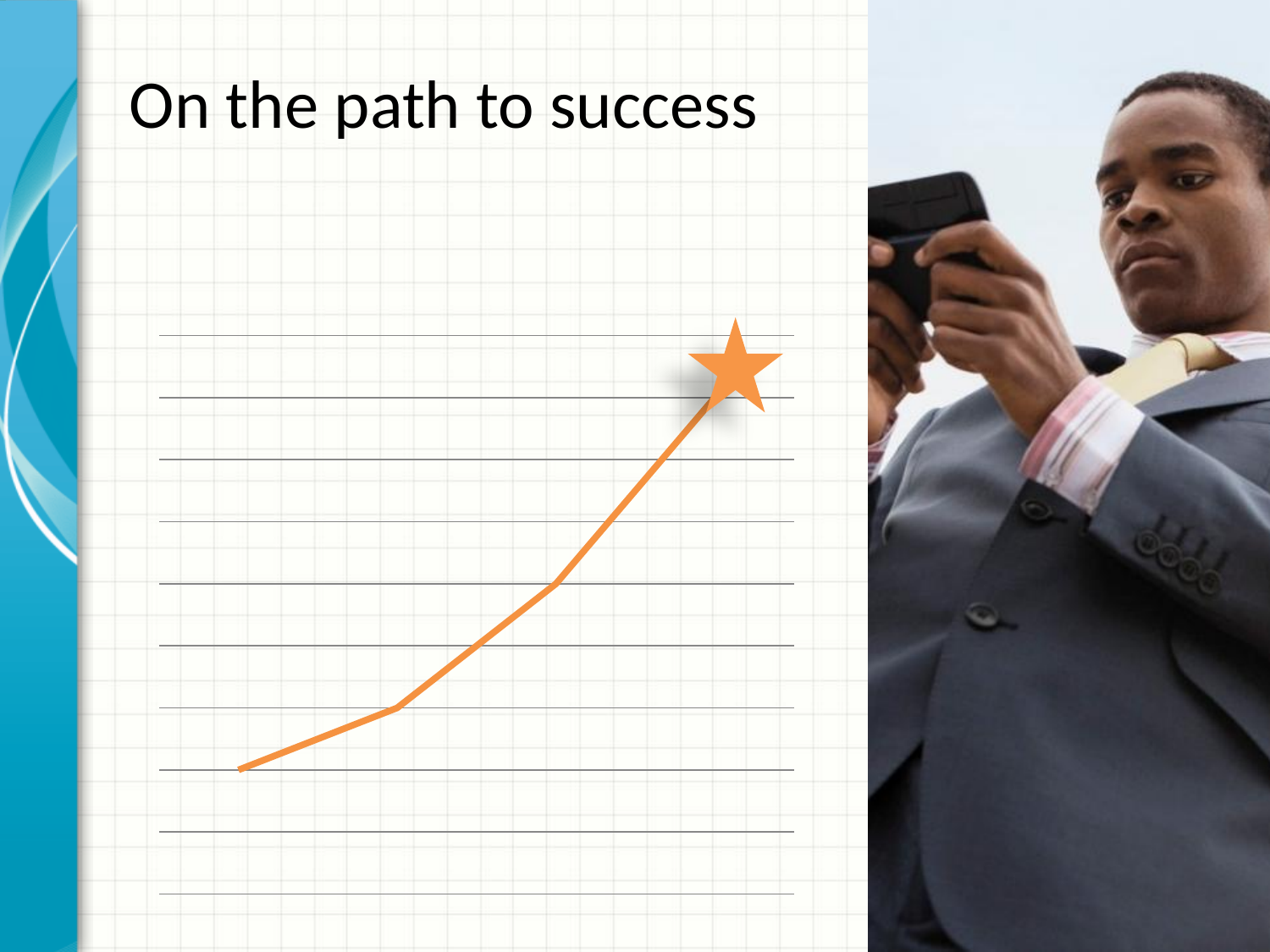
What shape marks the end of the plotted line? a star What colour is the plotted line on the chart? orange At which end of the line, left or right, is the plotted value highest? right Do the values of the plotted line rise or fall from left to right? rise What kind of chart is shown on the slide? line chart